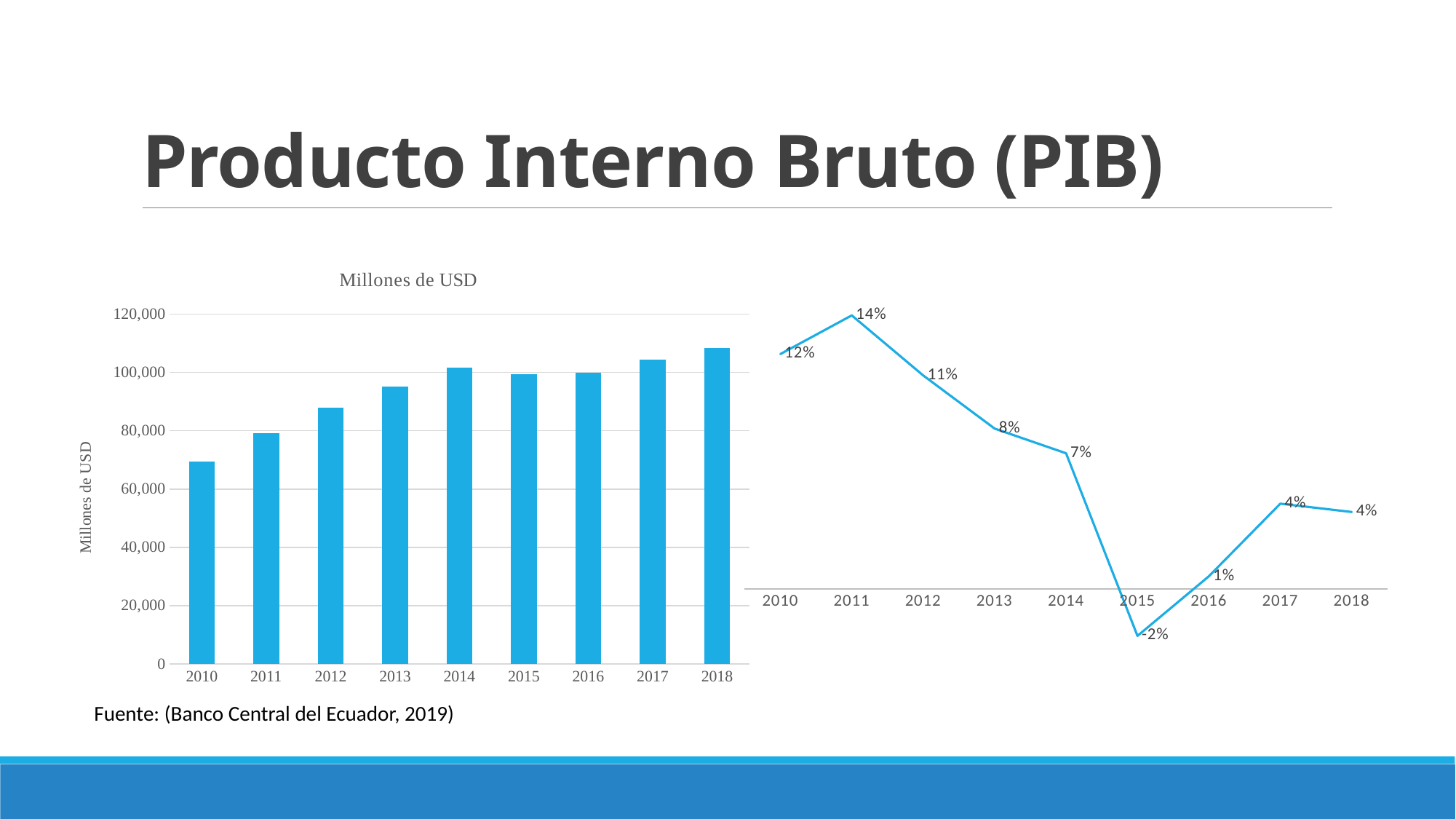
In the line chart on the right of the slide, what is the value for 2015? -2% In the bar chart titled 'Millones de USD', is the value for 2010 greater or less than 80,000? less In the bar chart titled 'Millones de USD', how many years are shown on the x axis? 9 In the bar chart titled 'Millones de USD', is the value for 2018 greater or less than 100,000? greater What kind of chart is the chart on the left of the slide? bar chart In the line chart on the right of the slide, what is the difference between the values for 2011 and 2010? 2% In the bar chart titled 'Millones de USD', which year has the lowest value? 2010 In the bar chart titled 'Millones de USD', is the value for 2013 greater or less than 100,000? less In the line chart on the right of the slide, which year has the lowest value? 2015 In the line chart on the right of the slide, which is larger, the value for 2014 or the value for 2016? 2014 In the bar chart titled 'Millones de USD', which year has the highest value? 2018 In the line chart on the right of the slide, what is the value for 2011? 14%